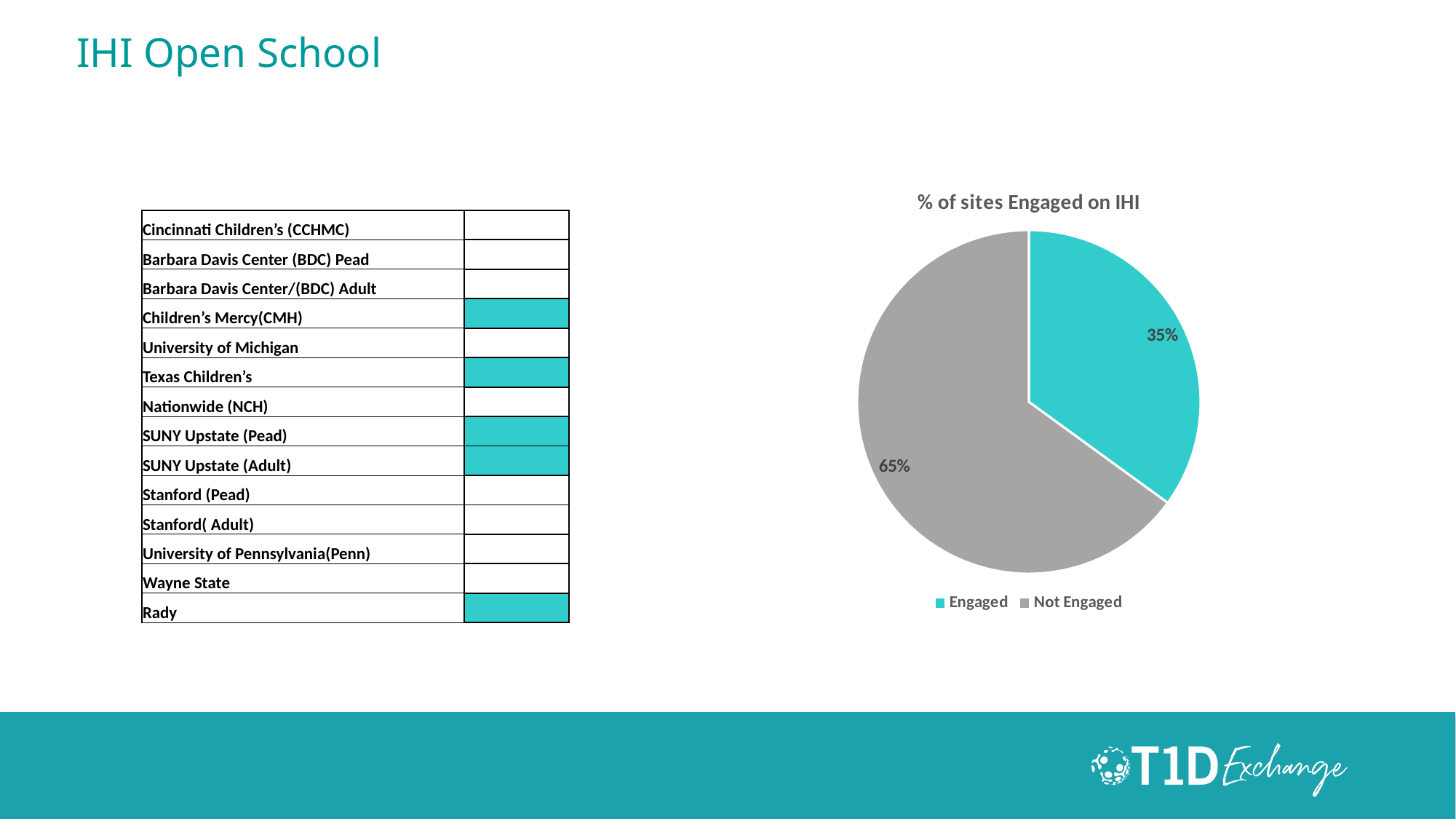
What colour represents the Engaged slice in the pie chart? teal Which slice of the pie chart is the largest? Not Engaged How many slices does the pie chart have? 2 Which slice of the pie chart is the smallest? Engaged What share of the pie does the Engaged slice represent? 35% How many entries does the chart legend list? 2 What percentage of sites are Not Engaged according to the chart? 65% What percentage of sites are Engaged according to the chart? 35% What type of chart is shown on the slide? pie chart Which is larger, the Engaged slice or the Not Engaged slice? Not Engaged What is the title of the chart? % of sites Engaged on IHI What is the difference in percentage points between the Not Engaged and Engaged slices? 30